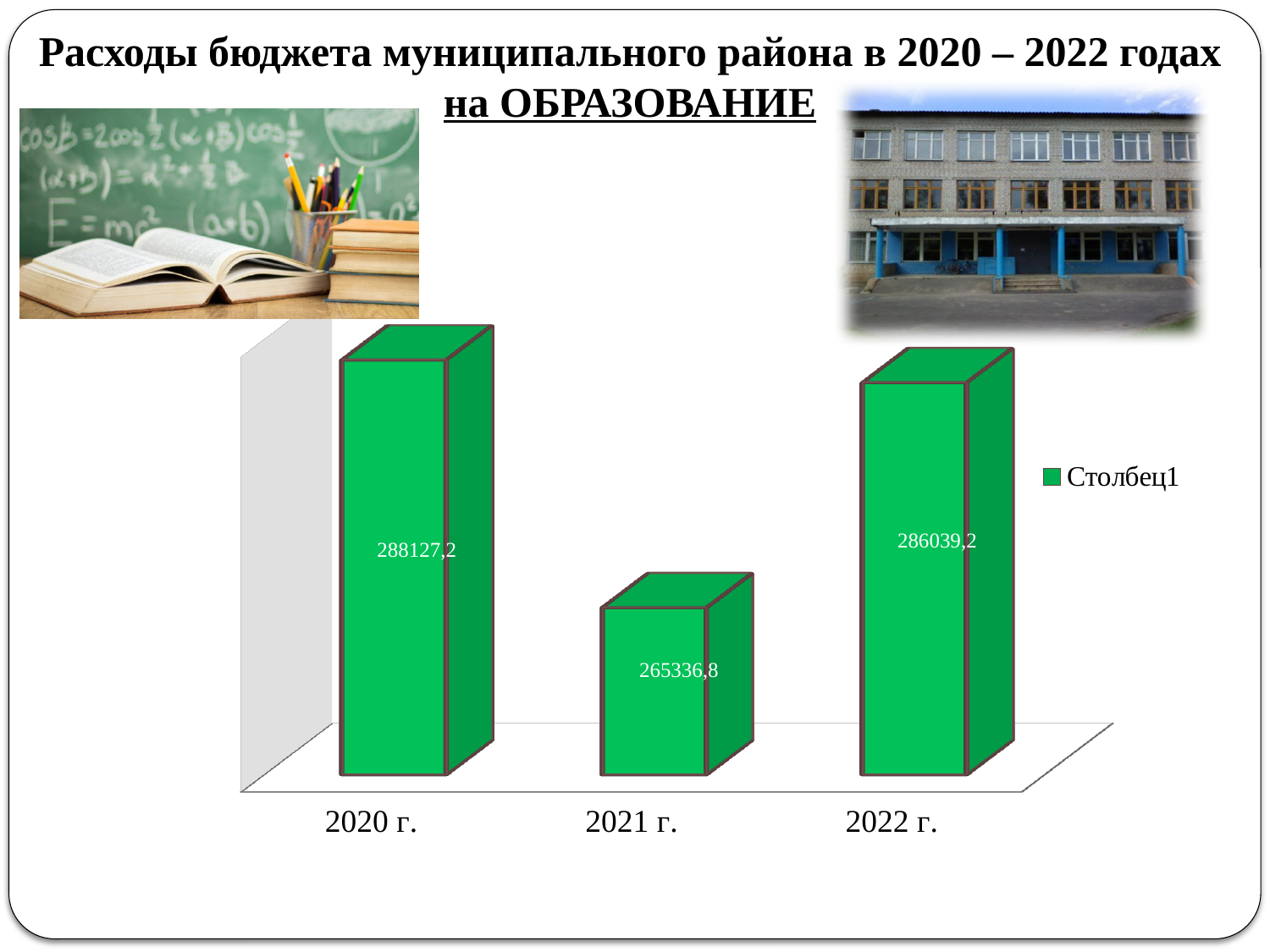
What kind of chart is shown on the slide? bar chart How many years are shown on the chart? 3 How many series does the legend list? 1 Which year has the lowest value? 2021 г. What is the value for 2021 г.? 265336,8 What is the name of the series in the legend? Столбец1 Which is larger, the value for 2021 г. or the value for 2022 г.? 2022 г. Which year has the highest value? 2020 г. What is the difference between the values for 2020 г. and 2021 г.? 22790,4 What is the value for 2020 г.? 288127,2 What is the difference between the values for 2022 г. and 2021 г.? 20702,4 What is the value for 2022 г.? 286039,2